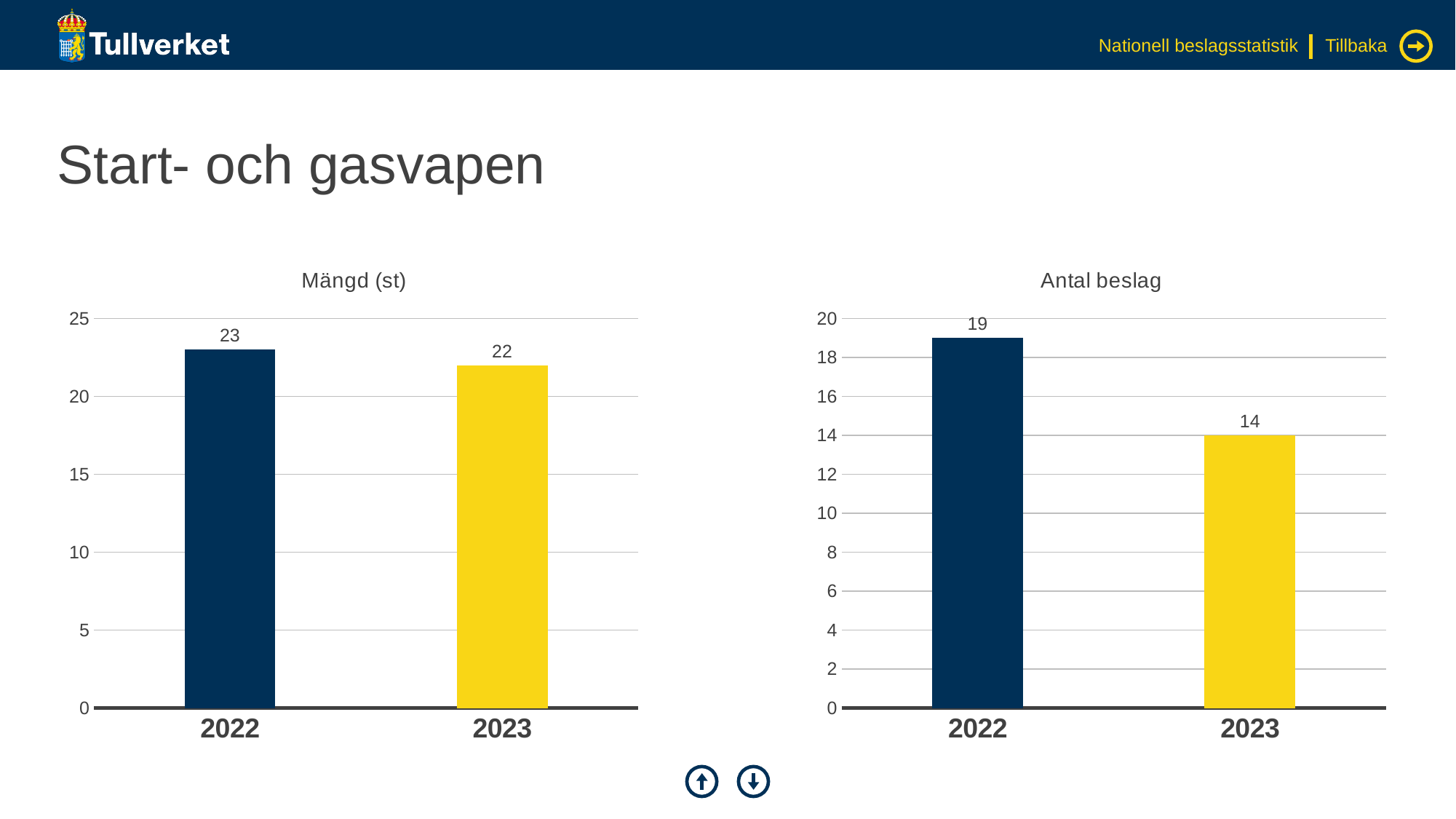
In the "Antal beslag" chart, is the value for 2023 greater or less than 16? less What kind of chart is the "Antal beslag" chart? bar chart How many categories are shown in the "Mängd (st)" chart? 2 In the "Antal beslag" chart, what is the value for 2023? 14 In the "Mängd (st)" chart, what is the value for 2022? 23 In the "Antal beslag" chart, which year has the highest value? 2022 In the "Antal beslag" chart, what is the value for 2022? 19 In the "Antal beslag" chart, do the values rise or fall from 2022 to 2023? fall In the "Mängd (st)" chart, what is the difference between the 2022 and 2023 values? 1 In the "Mängd (st)" chart, what is the value for 2023? 22 In the "Antal beslag" chart, what is the difference between the 2022 and 2023 values? 5 In the "Antal beslag" chart, which year has the lowest value? 2023